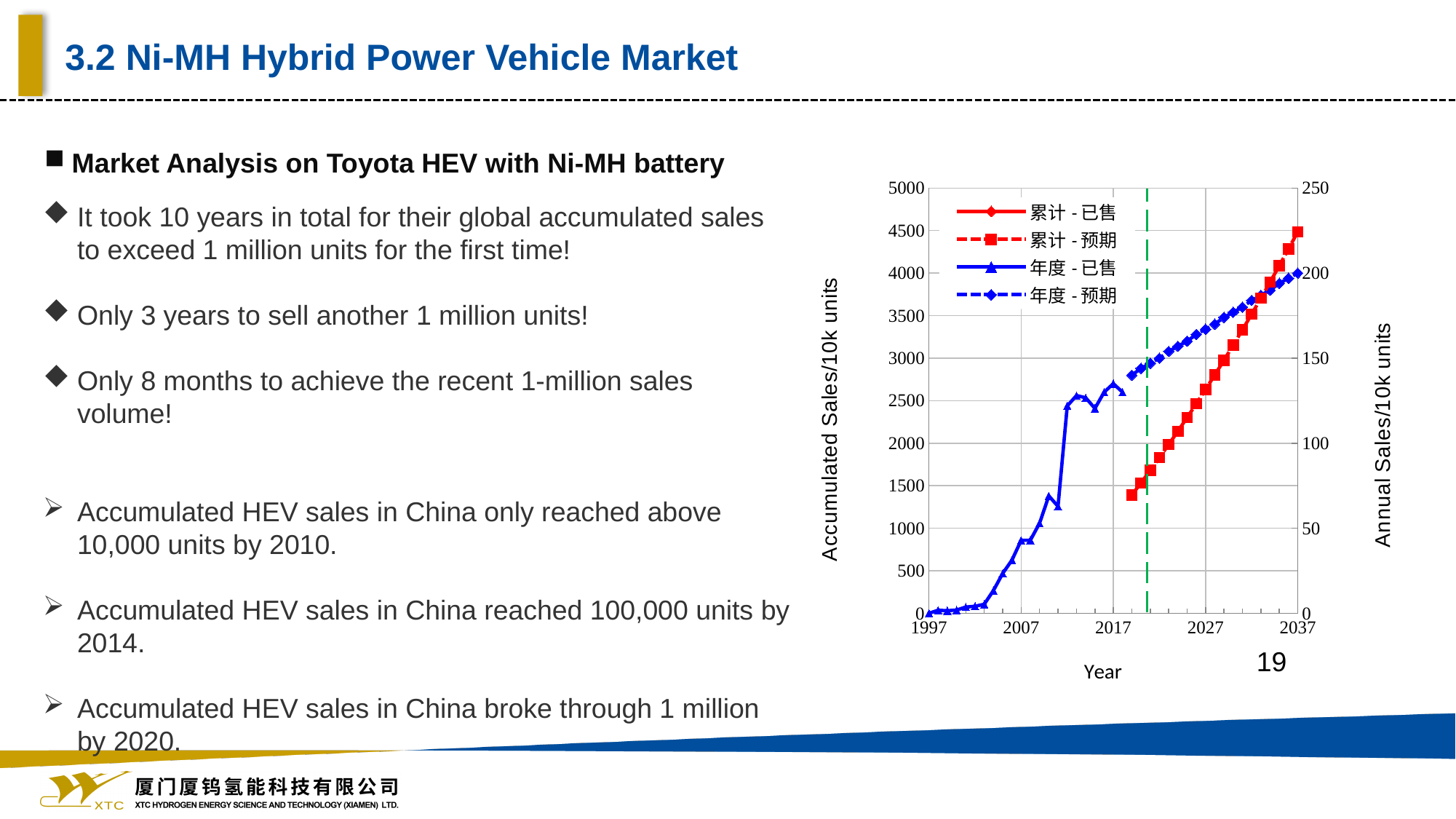
What is the title of the chart's x axis? Year How many series does the chart's legend list? 4 What is the first year label shown on the chart's x axis? 1997 What kind of chart is shown on the slide? Line chart Does the red 累计-预期 series rise or fall from 2018 to 2037? Rise What is the maximum value shown on the chart's left y axis? 5000 What is the title of the chart's left y axis? Accumulated Sales/10k units Does the blue 年度-预期 series rise or fall along the x axis? Rise What is the maximum value shown on the chart's right y axis? 250 What is the last year label shown on the chart's x axis? 2037 Which series in the legend is drawn with a solid red line? 累计-已售